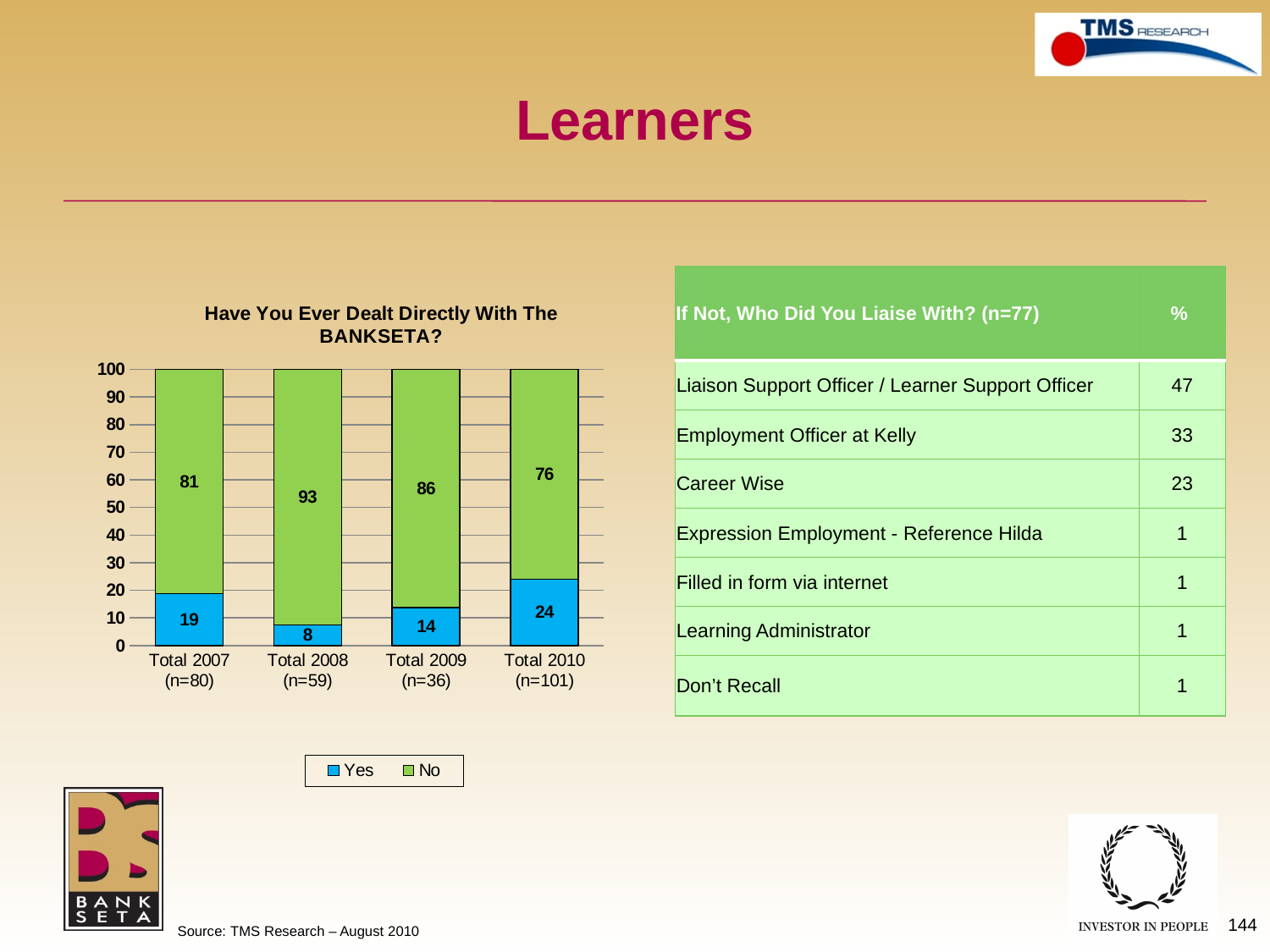
What is the title of the chart? Have You Ever Dealt Directly With The BANKSETA? Is the 'Yes' value larger for Total 2009 or Total 2007? Total 2007 What kind of chart is shown? Stacked bar chart How many series does the legend list? 2 What is the 'No' value for Total 2008 (n=59)? 93 How many year categories are shown on the x axis? 4 Which year has the highest 'No' value? Total 2008 (n=59) Which year has the lowest 'Yes' value? Total 2008 (n=59) What is the 'Yes' value for Total 2010 (n=101)? 24 What is the total of the stacked bar for Total 2009 (n=36)? 100 Do the 'Yes' values rise or fall from Total 2008 to Total 2010? Rise What is the difference between the 'Yes' values for Total 2010 and Total 2007? 5